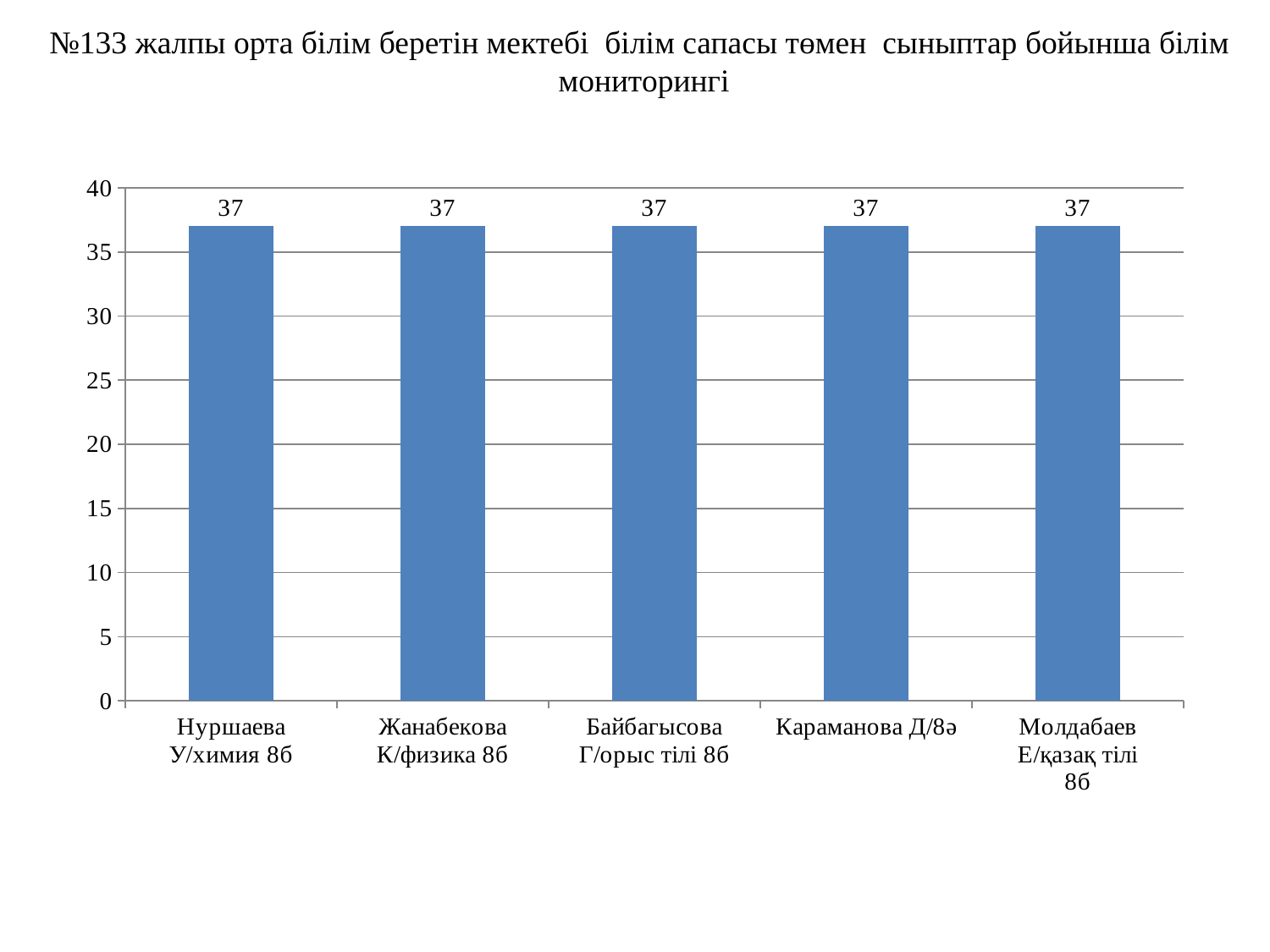
What is the difference between the values for Нуршаева У/химия 8б and Караманова Д/8ә? 0 What is the value for Караманова Д/8ә? 37 Do the values rise, fall, or stay the same across the categories from left to right? Stay the same Is the value for Молдабаев Е/қазақ тілі 8б greater or less than 40? less What is the value for Нуршаева У/химия 8б? 37 What is the highest value shown on the vertical axis? 40 What kind of chart is shown on the slide? Bar chart What is the value for Жанабекова К/физика 8б? 37 What is the value for Молдабаев Е/қазақ тілі 8б? 37 Is the value for Жанабекова К/физика 8б greater or less than 35? greater How many categories are shown on the chart? 5 What is the value for Байбагысова Г/орыс тілі 8б? 37